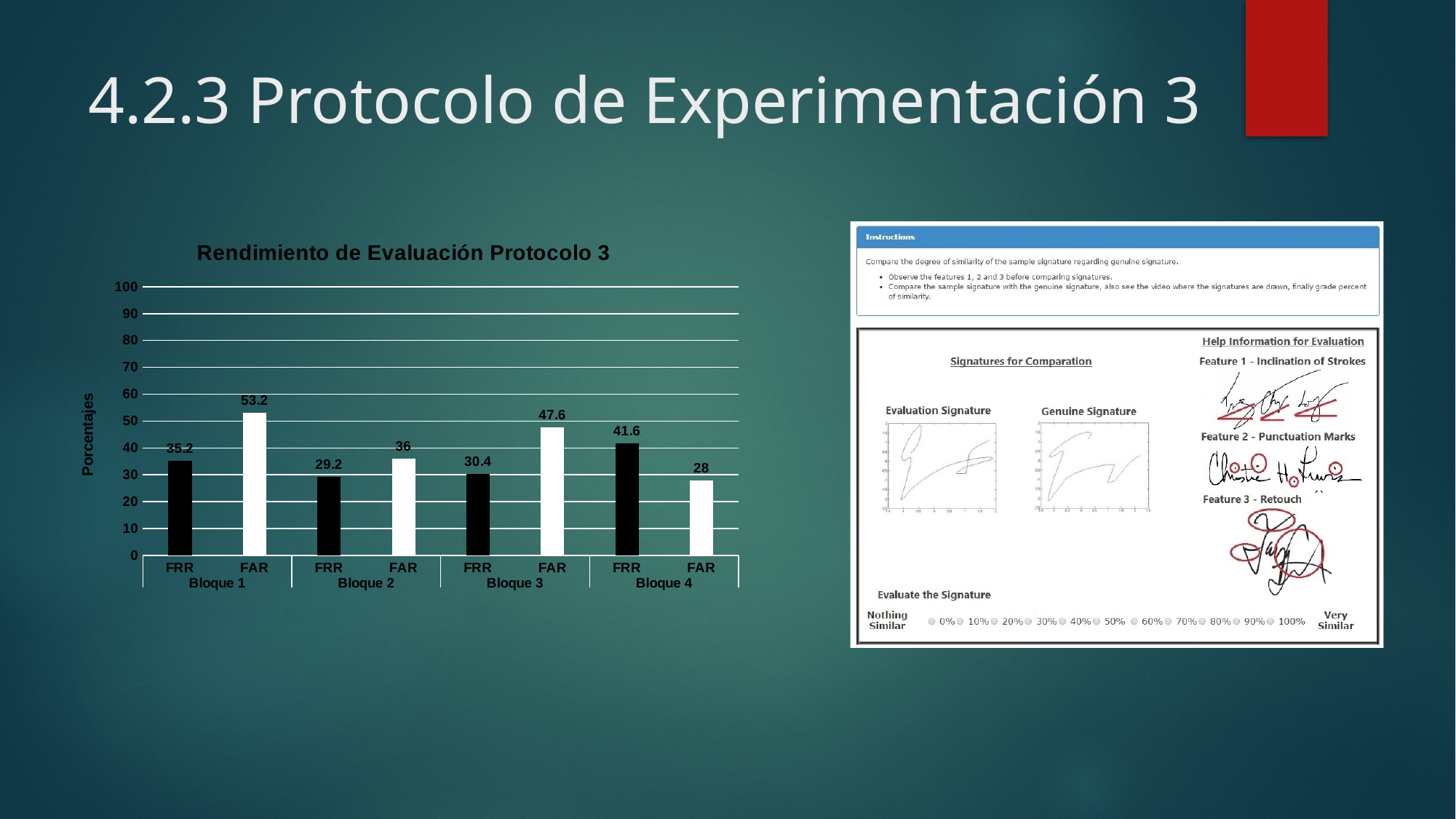
What is the FAR value for Bloque 1? 53.2 Which bar has the highest value in the chart? FAR, Bloque 1 What is the FRR value for Bloque 4? 41.6 Which is larger for Bloque 4, FRR or FAR? FRR What kind of chart is shown on the slide? bar chart Which bar has the lowest value in the chart? FAR, Bloque 4 How many bloques (groups) are shown on the x axis? 4 How many bars are plotted in the chart? 8 Is the FRR value for Bloque 2 greater or less than 30? less What is the FAR value for Bloque 2? 36 What is the difference between the FAR and FRR values for Bloque 3? 17.2 What is the title of the chart? Rendimiento de Evaluación Protocolo 3